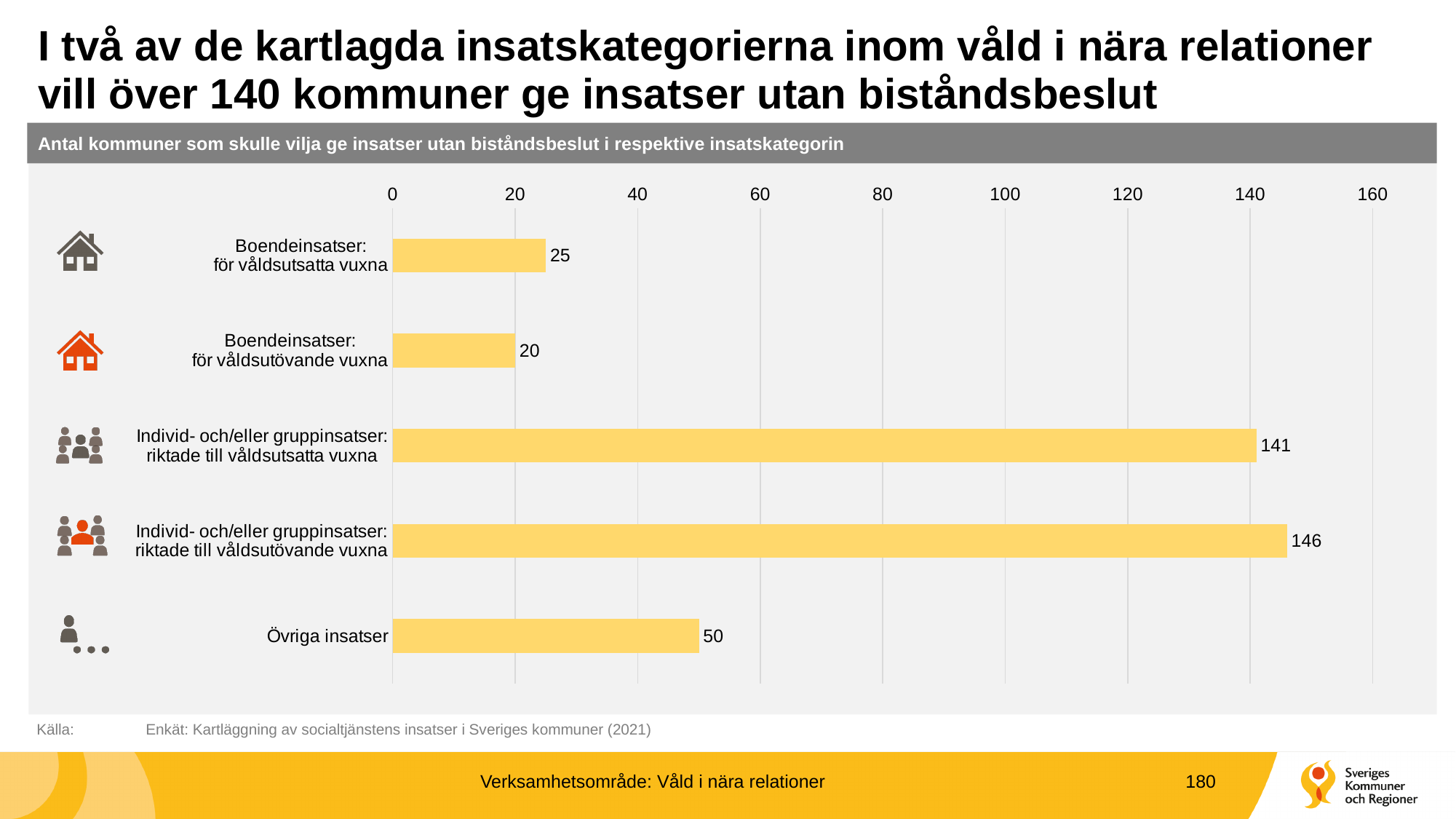
Which category has the highest value? Individ- och/eller gruppinsatser: riktade till våldsutövande vuxna What is the title of the chart? Antal kommuner som skulle vilja ge insatser utan biståndsbeslut i respektive insatskategorin What kind of chart is shown on the slide? bar chart What is the value for Övriga insatser? 50 What is the difference between the values for Övriga insatser and Boendeinsatser: för våldsutsatta vuxna? 25 Which category has the lowest value? Boendeinsatser: för våldsutövande vuxna Is the value for Individ- och/eller gruppinsatser: riktade till våldsutsatta vuxna greater or less than 100? greater How many categories are shown in the chart? 5 What is the value for Individ- och/eller gruppinsatser: riktade till våldsutövande vuxna? 146 Which is larger: the value for Boendeinsatser: för våldsutsatta vuxna or the value for Boendeinsatser: för våldsutövande vuxna? Boendeinsatser: för våldsutsatta vuxna What is the difference between the values for Individ- och/eller gruppinsatser: riktade till våldsutövande vuxna and Individ- och/eller gruppinsatser: riktade till våldsutsatta vuxna? 5 What is the value for Boendeinsatser: för våldsutsatta vuxna? 25